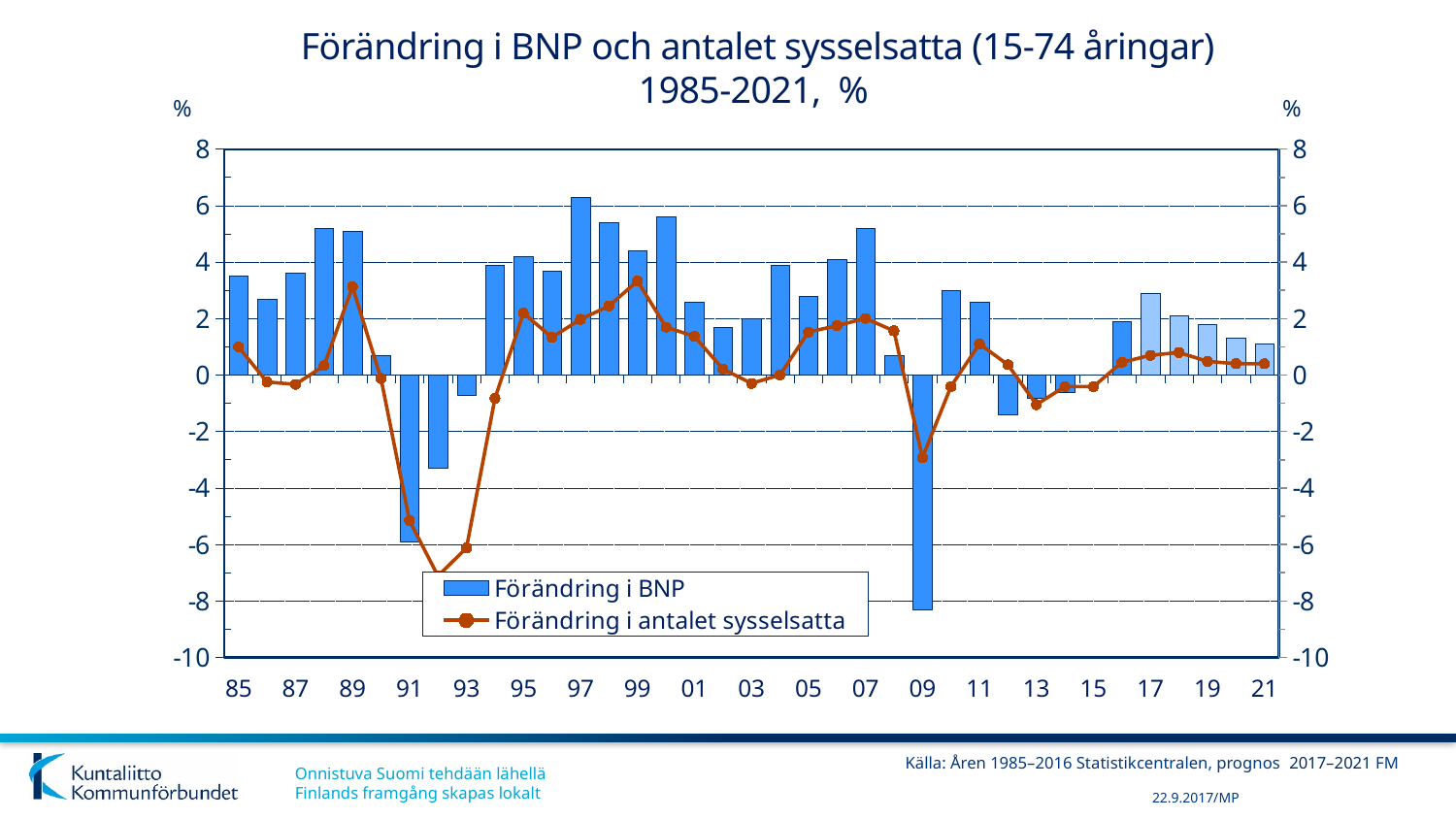
Which series is drawn as bars and which as a line with markers? Förändring i BNP is bars; Förändring i antalet sysselsatta is the line In which year does the Förändring i antalet sysselsatta line reach its lowest point? 1992 What are the two series named in the legend? Förändring i BNP and Förändring i antalet sysselsatta In which year is the Förändring i BNP bar the highest? 1997 Is the Förändring i BNP value for 2009 greater or less than -6? less Is the Förändring i antalet sysselsatta value for 1992 greater or less than -6? less Which year has the larger Förändring i BNP value, 1988 or 1990? 1988 In which year is the Förändring i BNP bar the lowest? 2009 Do the Förändring i BNP bars rise or fall from 2017 to 2021? fall How many series does the legend list? 2 What kind of chart is shown on the slide? A combined bar and line chart How many years does the chart cover, from 1985 to 2021? 37